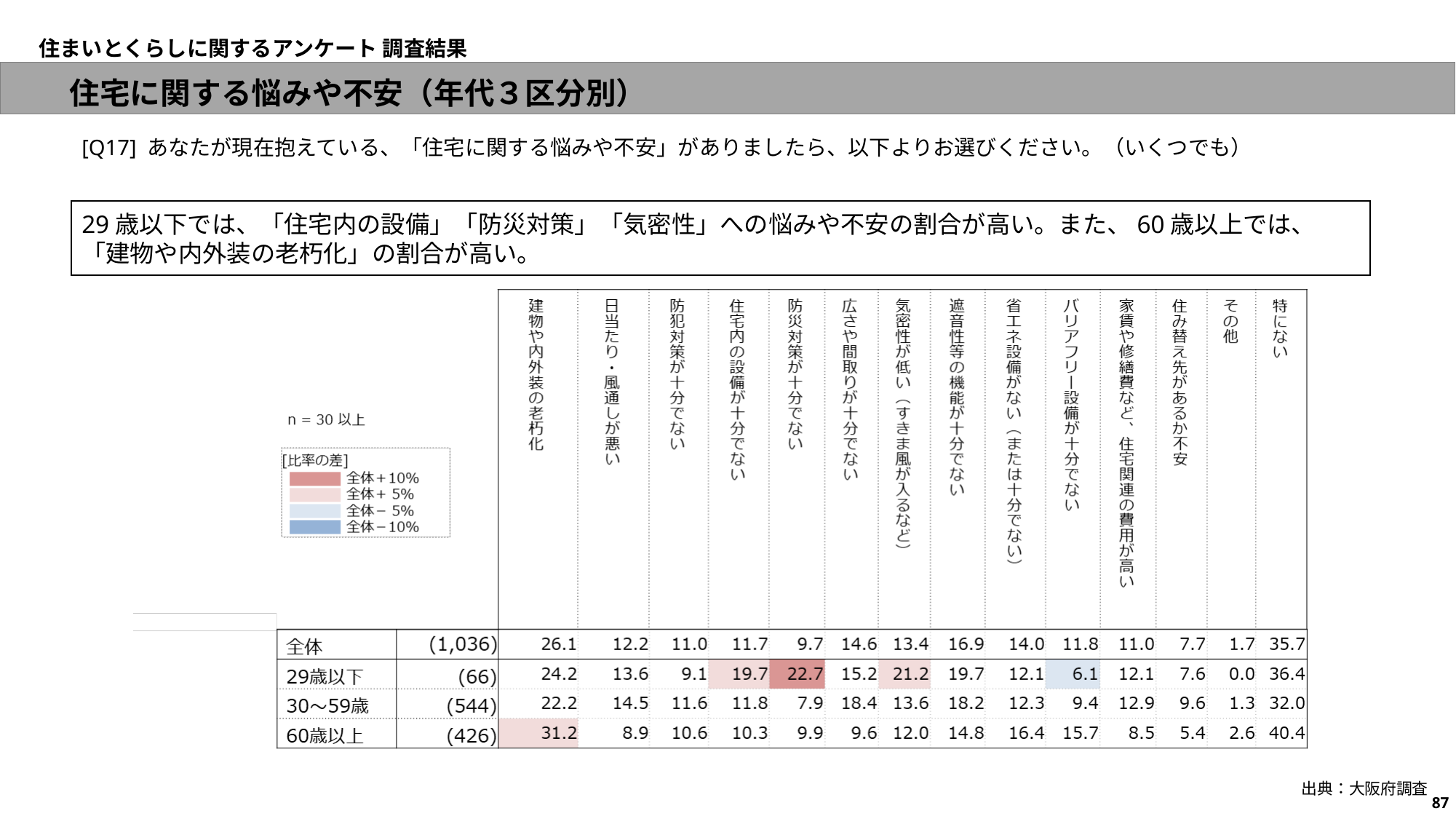
「広さや間取りが十分でない」で最も値が低い年代区分はどれですか？ 60歳以上 「建物や内外装の老朽化」で最も値が高い年代区分はどれですか？ 60歳以上 凡例「比率の差」で「全体＋10%」を示す色は何色ですか？ 濃い赤 全体を除くと、年代区分はいくつありますか？ 3 「特にない」の全体の値はいくつですか？ 35.7 「防災対策が十分でない」の29歳以下の値はいくつですか？ 22.7 「バリアフリー設備が十分でない」の29歳以下の値はいくつですか？ 6.1 「住宅内の設備が十分でない」では、29歳以下と30〜59歳のどちらの値が大きいですか？ 29歳以下 悩みや不安の項目（列）はいくつありますか？ 14 29歳以下の回答者数（n）はいくつですか？ 66 「建物や内外装の老朽化」の60歳以上の値はいくつですか？ 31.2 「気密性が低い」の29歳以下と全体の値の差はいくつですか？ 7.8